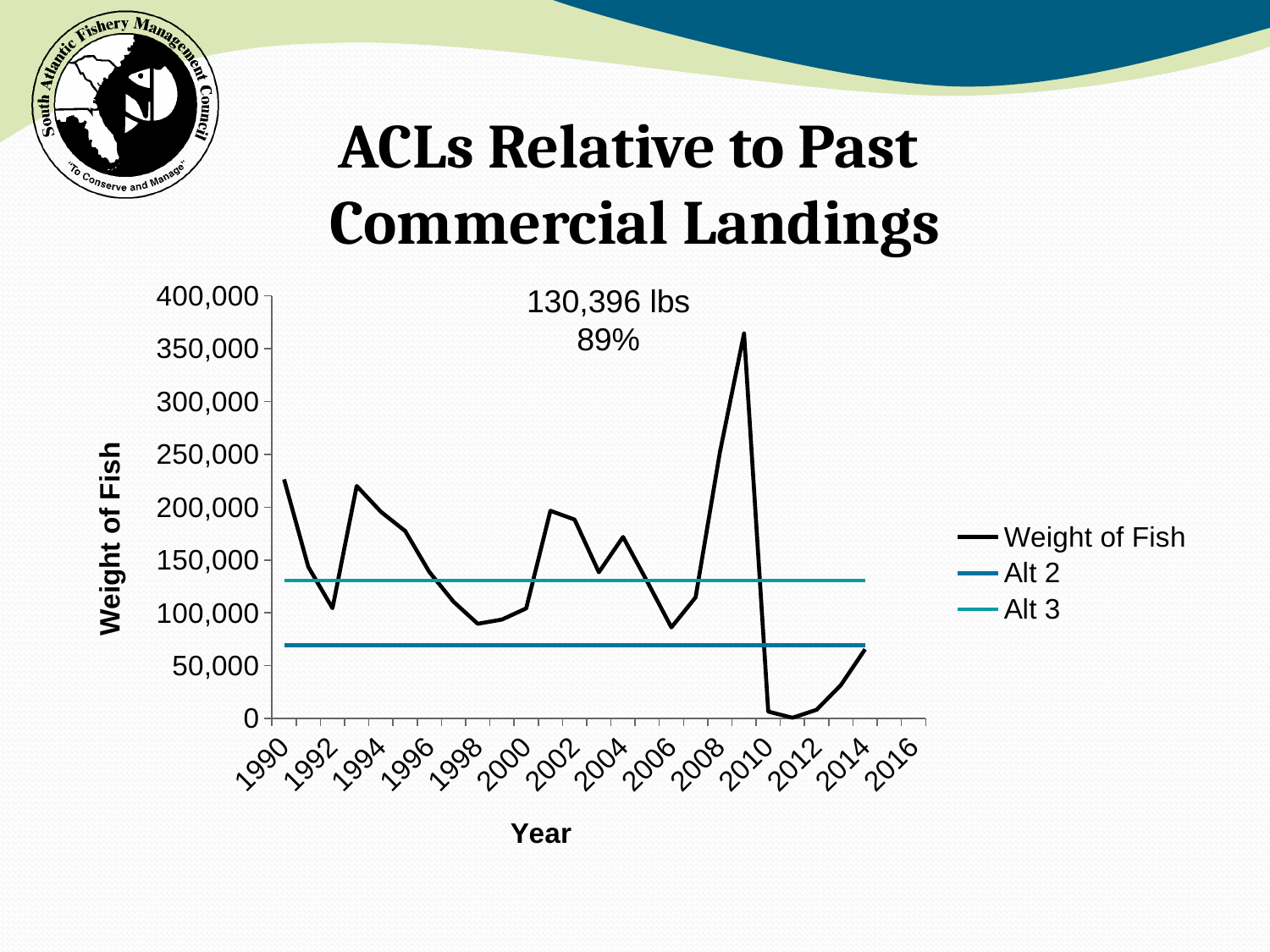
In which year is the Weight of Fish series at its lowest? 2011 What kind of chart is shown on the slide? line chart Which year has a larger Weight of Fish value, 1990 or 1992? 1990 Which is higher, the Alt 2 line or the Alt 3 line? Alt 3 Is the Alt 2 line greater or less than 100,000? less What is the title of the chart's y axis? Weight of Fish How many series does the legend list? 3 Is the Weight of Fish value for 1990 greater or less than 200,000? greater Is the Weight of Fish value for 2011 greater or less than 50,000? less In which year does the Weight of Fish series reach its highest value? 2009 Does the Weight of Fish series rise or fall between 2009 and 2011? fall